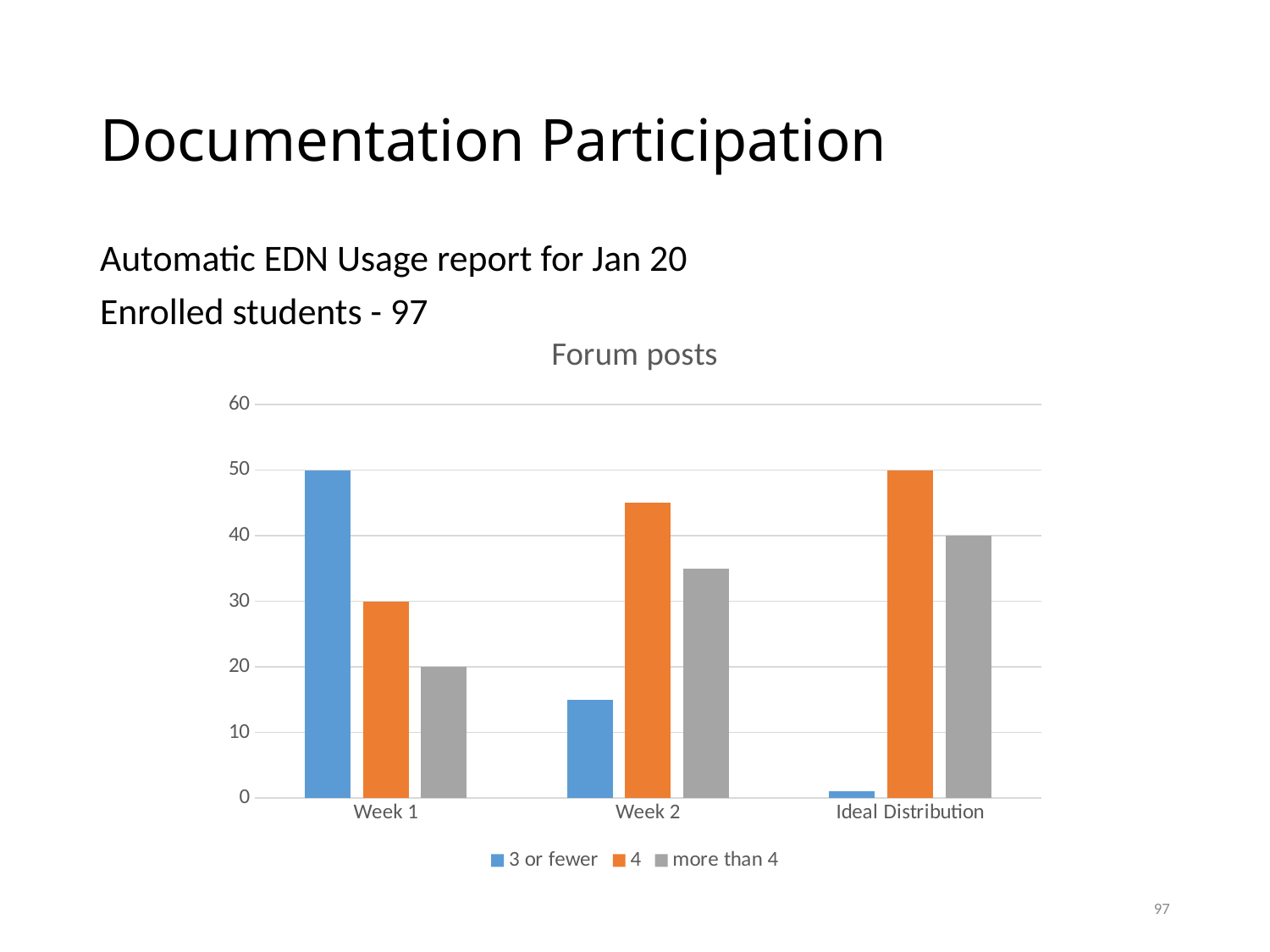
What is the value for '4' in Ideal Distribution? 50 Is the value for '3 or fewer' in Week 2 greater or less than 20? less What is the value for '3 or fewer' in Week 1? 50 What is the title of the chart? Forum posts What kind of chart is shown on the slide? bar chart Is the value for '4' in Week 2 greater or less than 40? greater What is the value for 'more than 4' in Ideal Distribution? 40 How many categories are shown on the x axis? 3 How many series does the legend list? 3 What is the value for 'more than 4' in Week 1? 20 Which series has the highest value in Week 1? 3 or fewer What is the value for '4' in Week 1? 30